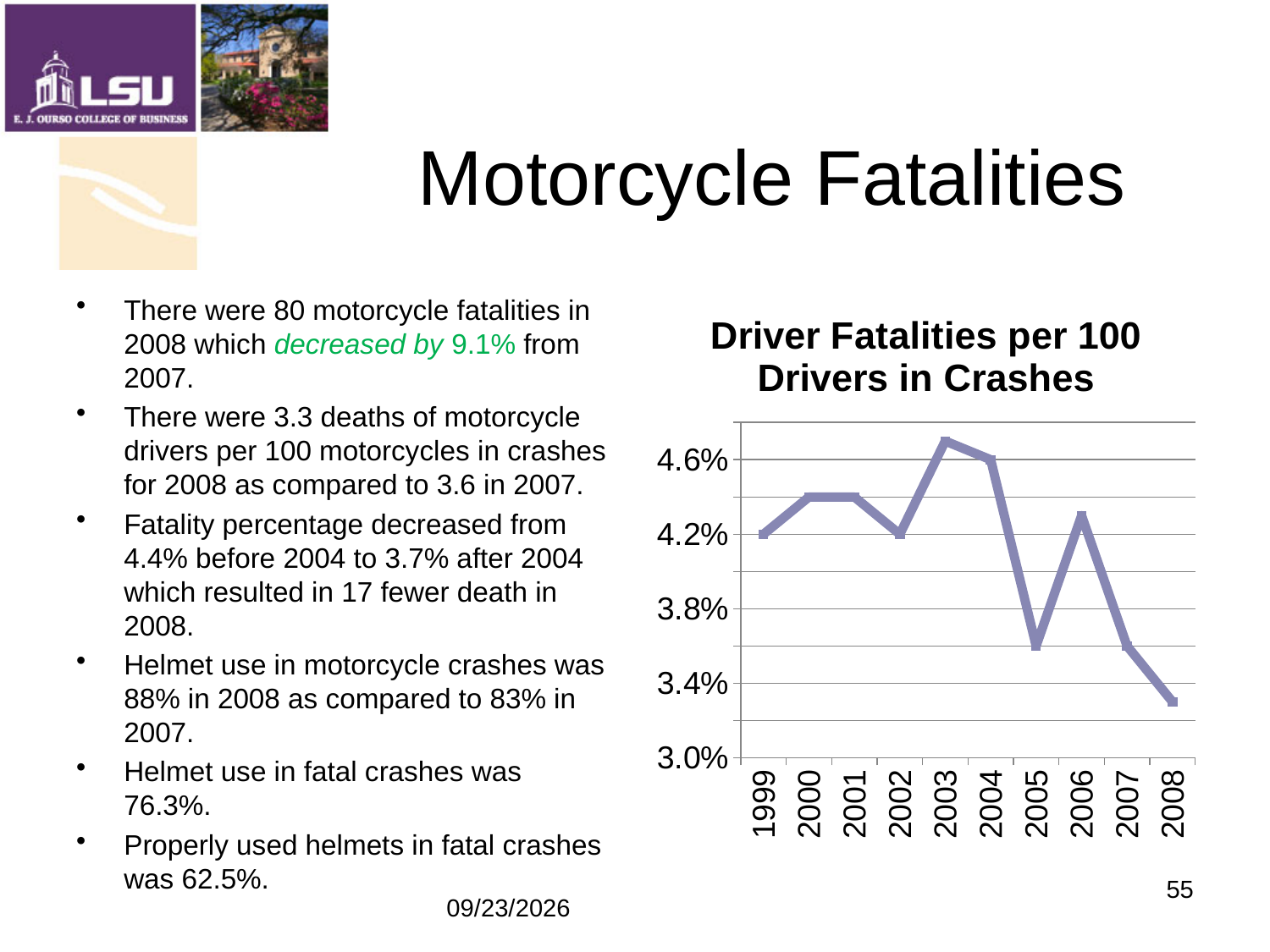
Is the value for 2008 greater or less than 3.4%? less How many years are plotted on the x axis of the chart? 10 Which year has a higher value, 2003 or 2005? 2003 What is the title of the chart? Driver Fatalities per 100 Drivers in Crashes Which year has a higher value, 2006 or 2007? 2006 What type of chart is shown on the slide? line chart Is the value for 2005 greater or less than 3.8%? less Is the value for 2003 greater or less than 4.6%? greater Which year has the lowest driver fatality percentage in the chart? 2008 Which year has the highest driver fatality percentage in the chart? 2003 Overall, does the driver fatality percentage rise or fall from 1999 to 2008? fall